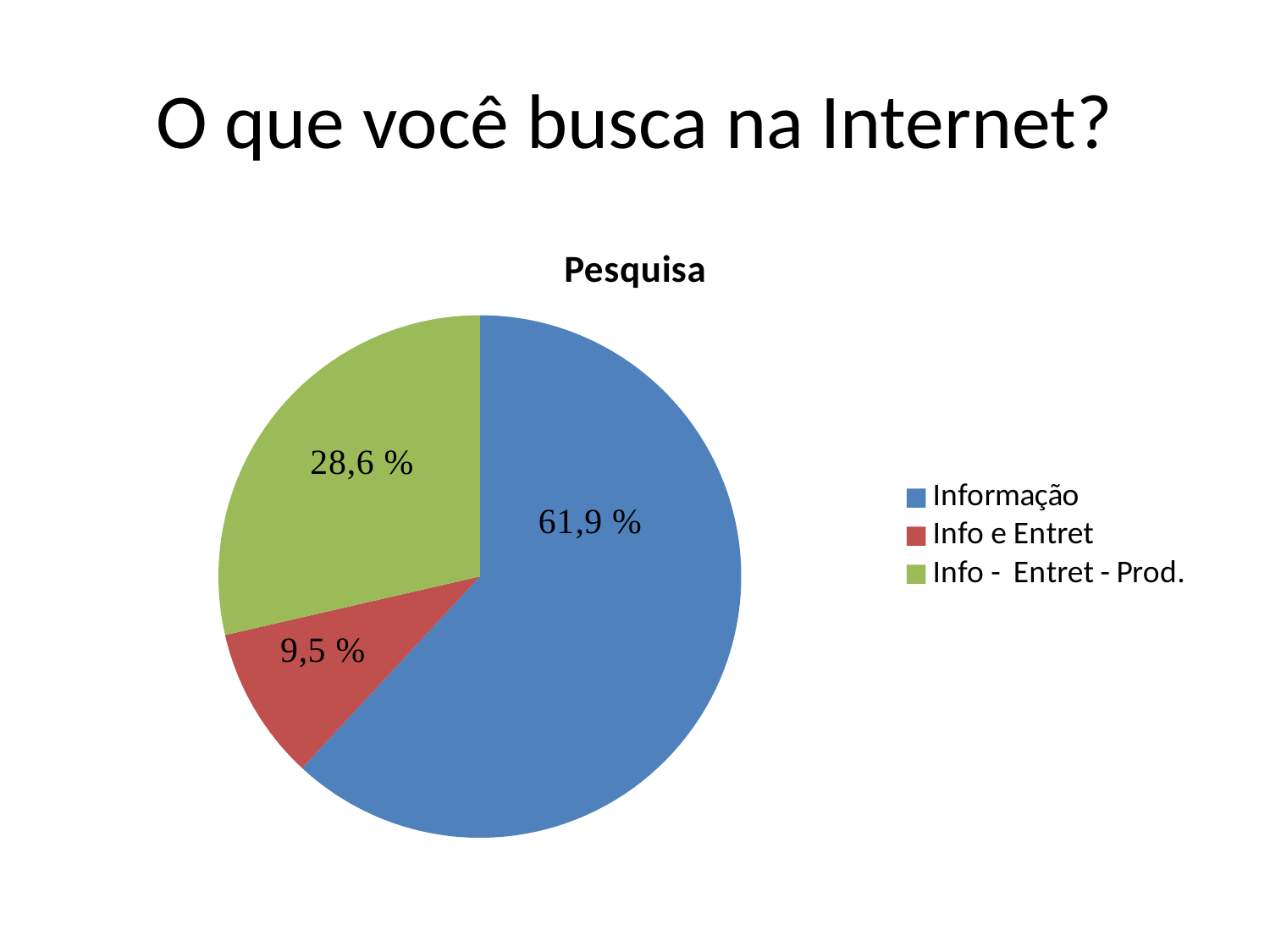
Which category has the smallest slice of the pie? Info e Entret What share of the pie does Info - Entret - Prod. have? 28,6 % What colour is the slice for Info e Entret? red Which category has the largest slice of the pie? Informação What share of the pie does Info e Entret have? 9,5 % What type of chart is shown on the slide? pie chart How many entries does the legend list? 3 How many slices does the pie chart have? 3 What is the difference in percentage points between the Informação slice and the Info - Entret - Prod. slice? 33,3 % What is the title of the chart? Pesquisa What share of the pie does Informação have? 61,9 % Which is larger, the slice for Info - Entret - Prod. or the slice for Info e Entret? Info - Entret - Prod.